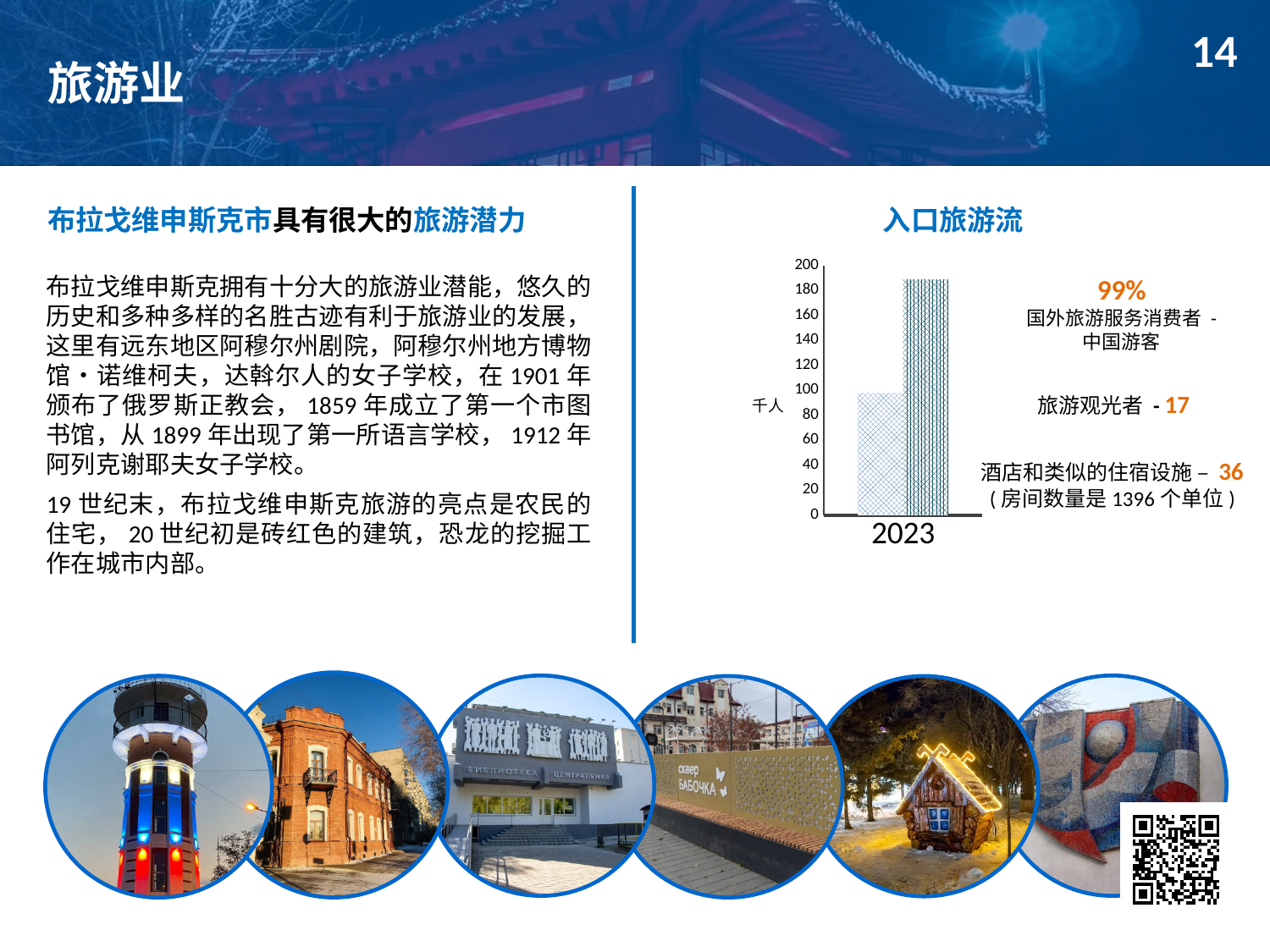
What is the title of the chart on the right side of the slide? 入口旅游流 What unit label is shown next to the y axis of the 入口旅游流 chart? 千人 What kind of chart is shown under the title 入口旅游流? bar chart Which year is labelled on the x axis of the 入口旅游流 chart? 2023 In the 入口旅游流 chart, is the value of the right (hatched) bar greater or less than 200? less In the 入口旅游流 chart, is the value of the left (dotted) bar greater or less than 120? less In the 入口旅游流 chart, is the value of the left (dotted) bar greater or less than 80? greater How many categories are shown on the x axis of the 入口旅游流 chart? 1 What is the maximum value shown on the y axis of the 入口旅游流 chart? 200 In the 入口旅游流 chart, which bar is taller, the left dotted bar or the right hatched bar? the right hatched bar